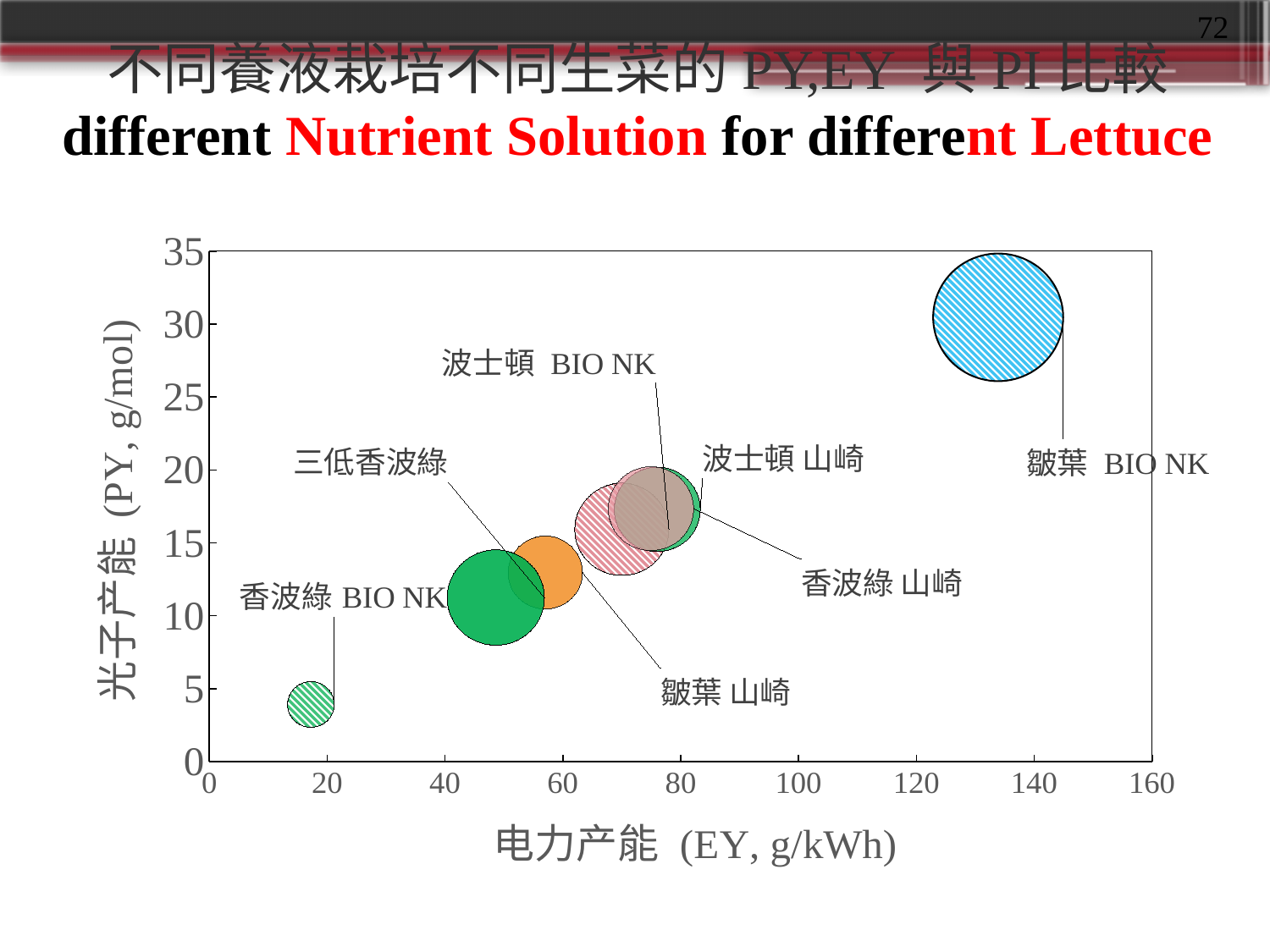
Is the PY value for 香波綠 BIO NK greater or less than 10 g/mol? less Which labelled bubble has the lowest photon yield (PY) value? 香波綠 BIO NK As EY increases along the x axis, does PY generally rise or fall? rise Which labelled bubble has the highest photon yield (PY) value? 皺葉 BIO NK How many labelled bubbles are shown in the chart? 7 Is the EY value for 香波綠 BIO NK greater or less than 20 g/kWh? less Is the EY value for 皺葉 山崎 greater or less than 60 g/kWh? greater What kind of chart is shown on the slide? bubble chart Which has a higher EY value, 皺葉 BIO NK or 三低香波綠? 皺葉 BIO NK What is the label of the x axis of the chart? 电力产能 (EY, g/kWh)